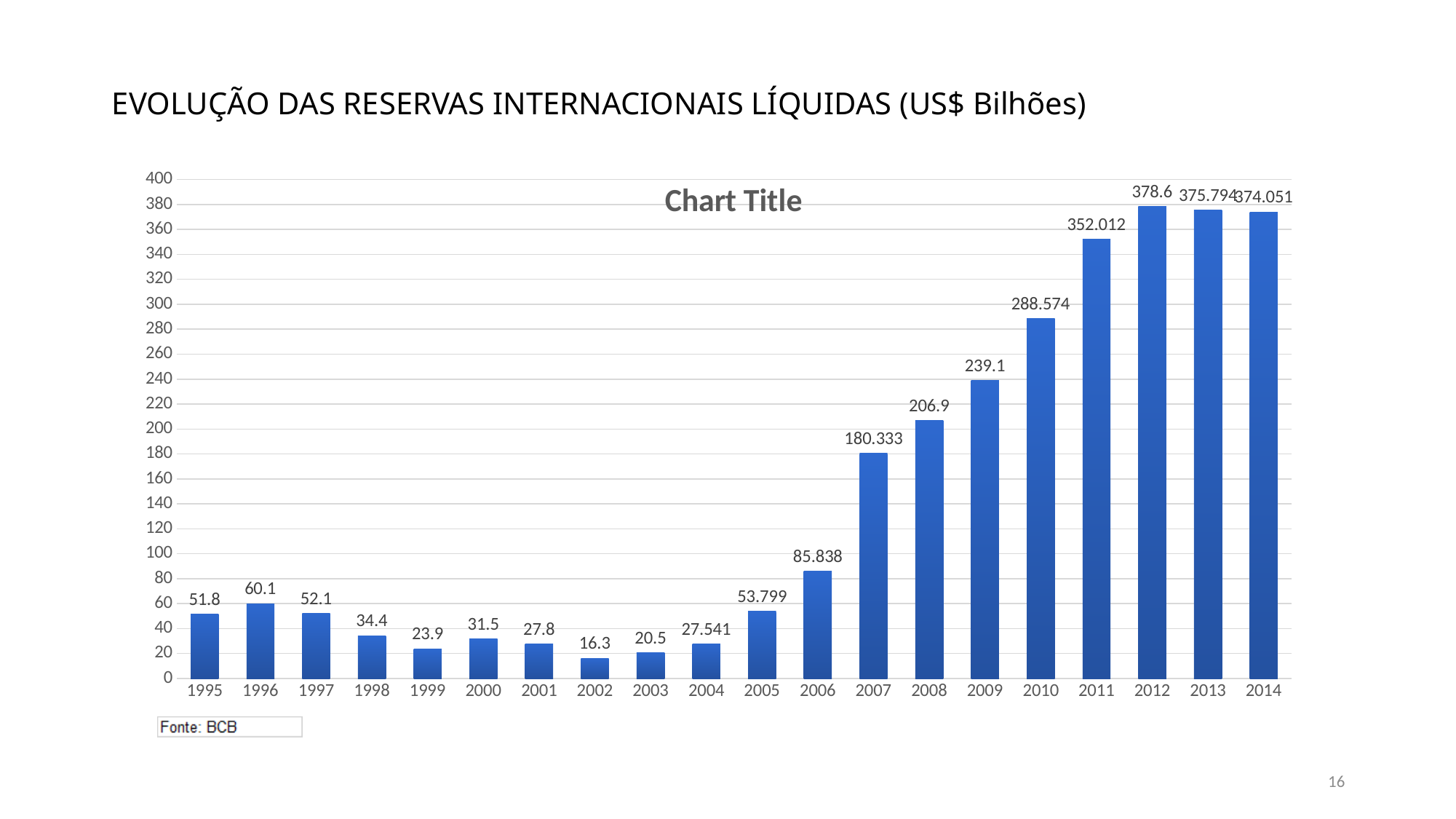
What is the difference between the values for 2009 and 2008? 32.2 Which year has the highest value? 2012 Which year has the lowest value? 2002 What source is cited below the chart? Fonte: BCB Which is larger, the value for 1996 or the value for 1997? 1996 Do the values generally rise or fall from 2003 to 2012? rise Is the value for 2010 greater or less than 260? greater What kind of chart is this? bar chart What is the value for 2006? 85.838 How many years are shown on the x axis? 20 What is the value for 2011? 352.012 What is the value for 1998? 34.4